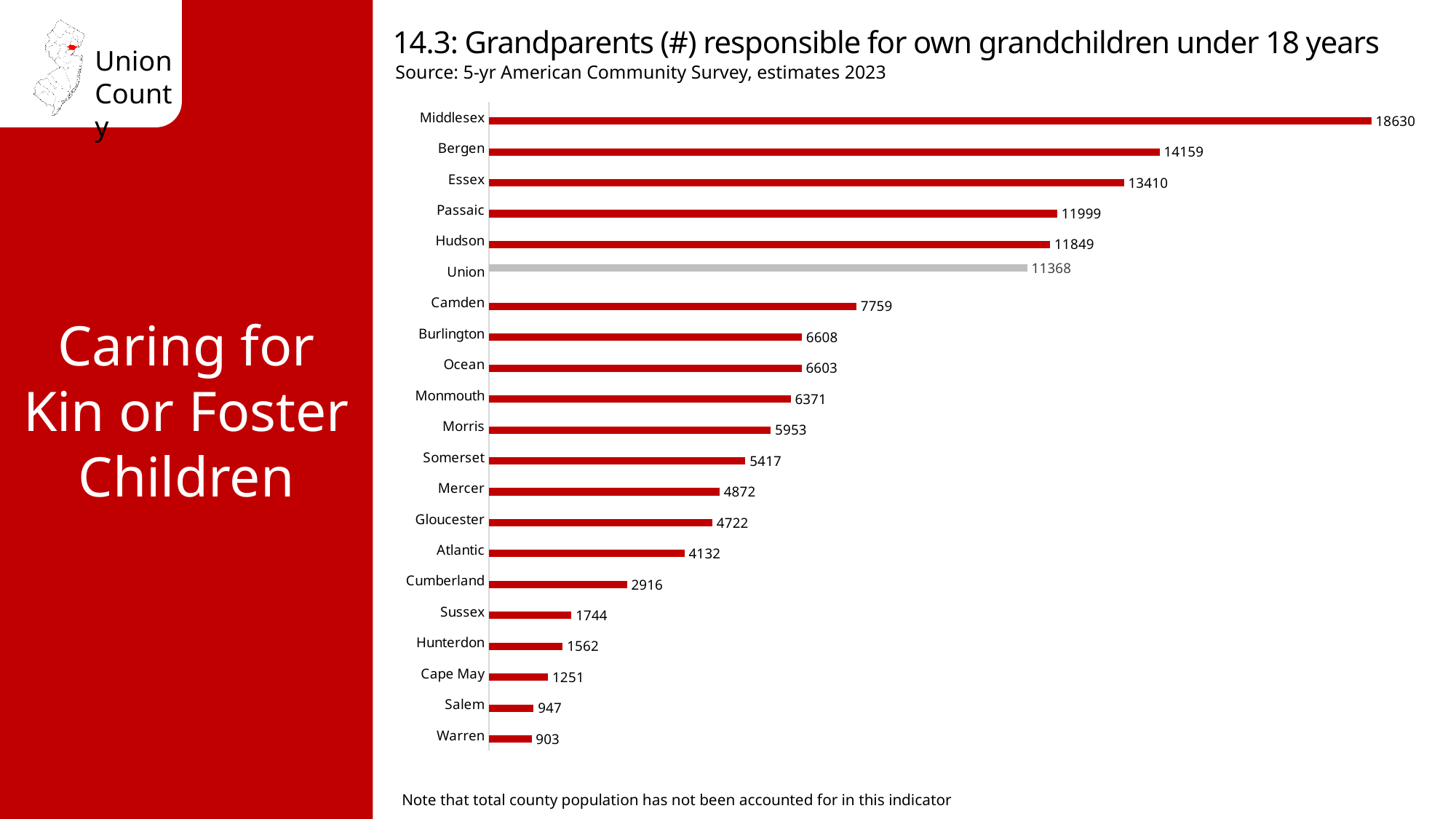
What is the value for Cape May? 1251 Which is larger, the value for Sussex or the value for Hunterdon? Sussex Which county has the lowest value? Warren Which is larger, the value for Passaic or the value for Hudson? Passaic What is the difference between the values for Middlesex and Bergen? 4471 What kind of chart is shown on the slide? Bar chart What is the difference between the values for Union and Camden? 3609 What is the value for Camden? 7759 Which county has the highest value? Middlesex How many counties are shown in the chart? 21 Which county's bar is shown in grey instead of red? Union What is the value for Union? 11368